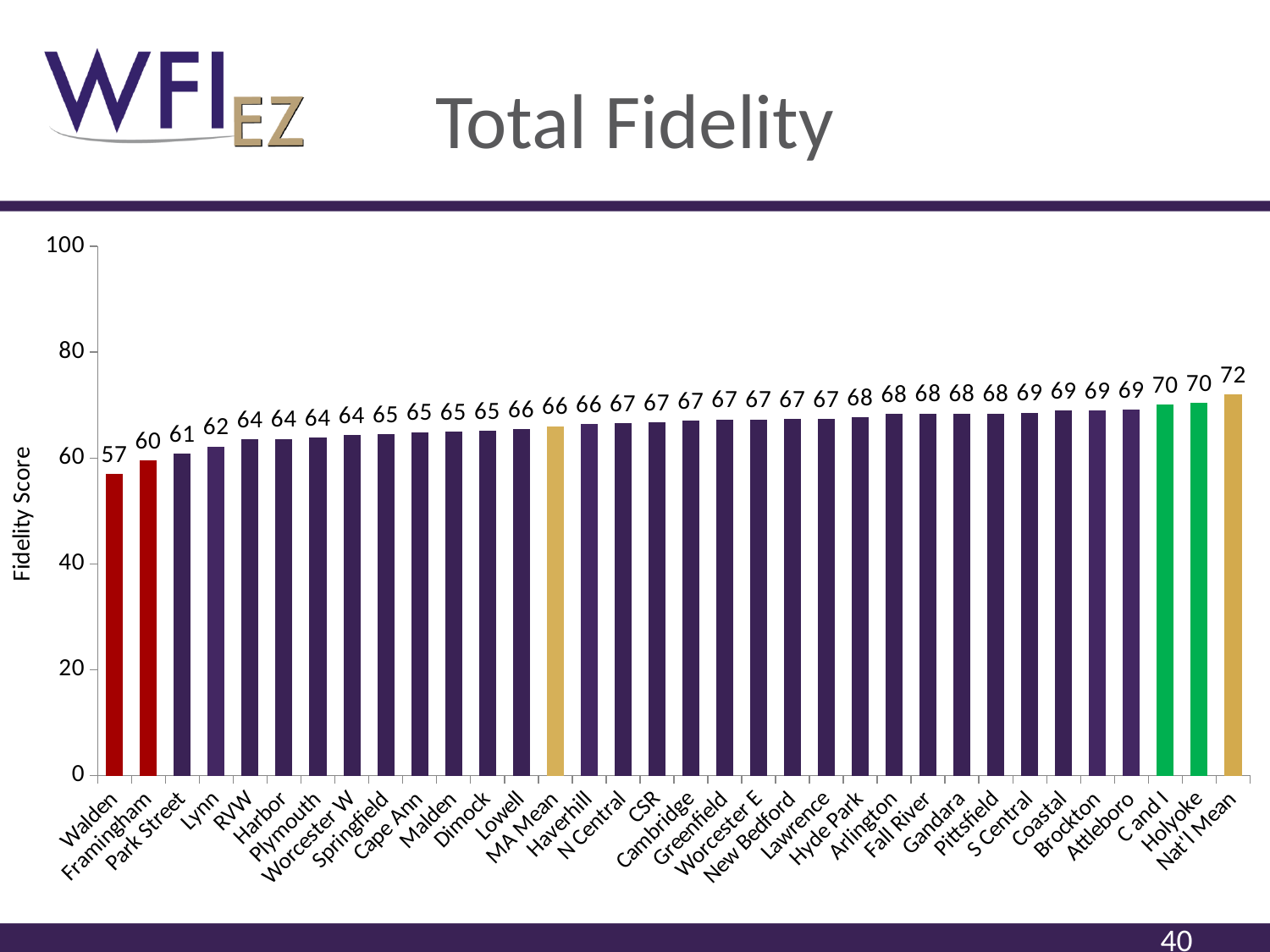
What is the fidelity score for Holyoke? 70 Do the fidelity scores rise or fall from left to right along the x axis? Rise Which has a higher fidelity score, Framingham or Attleboro? Attleboro Which category has the highest fidelity score? Nat'l Mean What is the fidelity score for Lynn? 62 What is the difference between the fidelity scores of Framingham and Park Street? 1 What kind of chart is shown on the slide? Bar chart How many bars are shown in the chart? 34 What is the difference between the Nat'l Mean fidelity score and the Walden fidelity score? 15 What is the fidelity score for MA Mean? 66 What is the fidelity score for Walden? 57 Which category has the lowest fidelity score? Walden